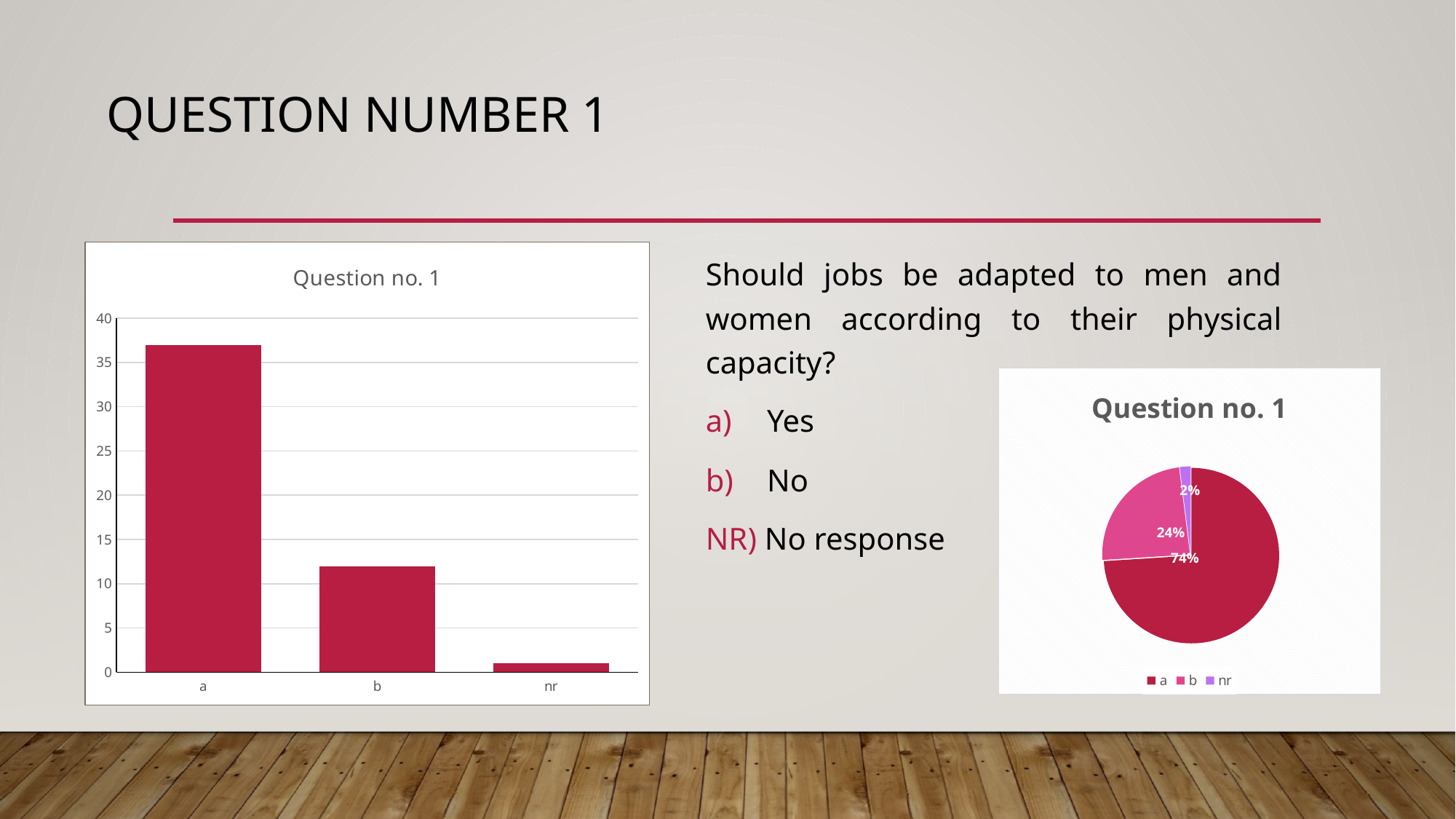
In the pie chart on the right, what share does slice nr have? 2% In the bar chart on the left, which is larger, the bar for a or the bar for b? a In the bar chart on the left, which category has the highest bar? a In the pie chart on the right, how many entries does the legend list? 3 In the pie chart on the right, what share does slice a have? 74% In the bar chart on the left, is the value for b greater or less than 15? less In the pie chart on the right, what share does slice b have? 24% In the bar chart on the left, which category has the lowest bar? nr What kind of chart is the chart on the right of the slide? pie chart In the bar chart on the left, is the value for a greater or less than 35? greater What kind of chart is the chart on the left of the slide? bar chart How many categories are shown on the x axis of the bar chart on the left? 3